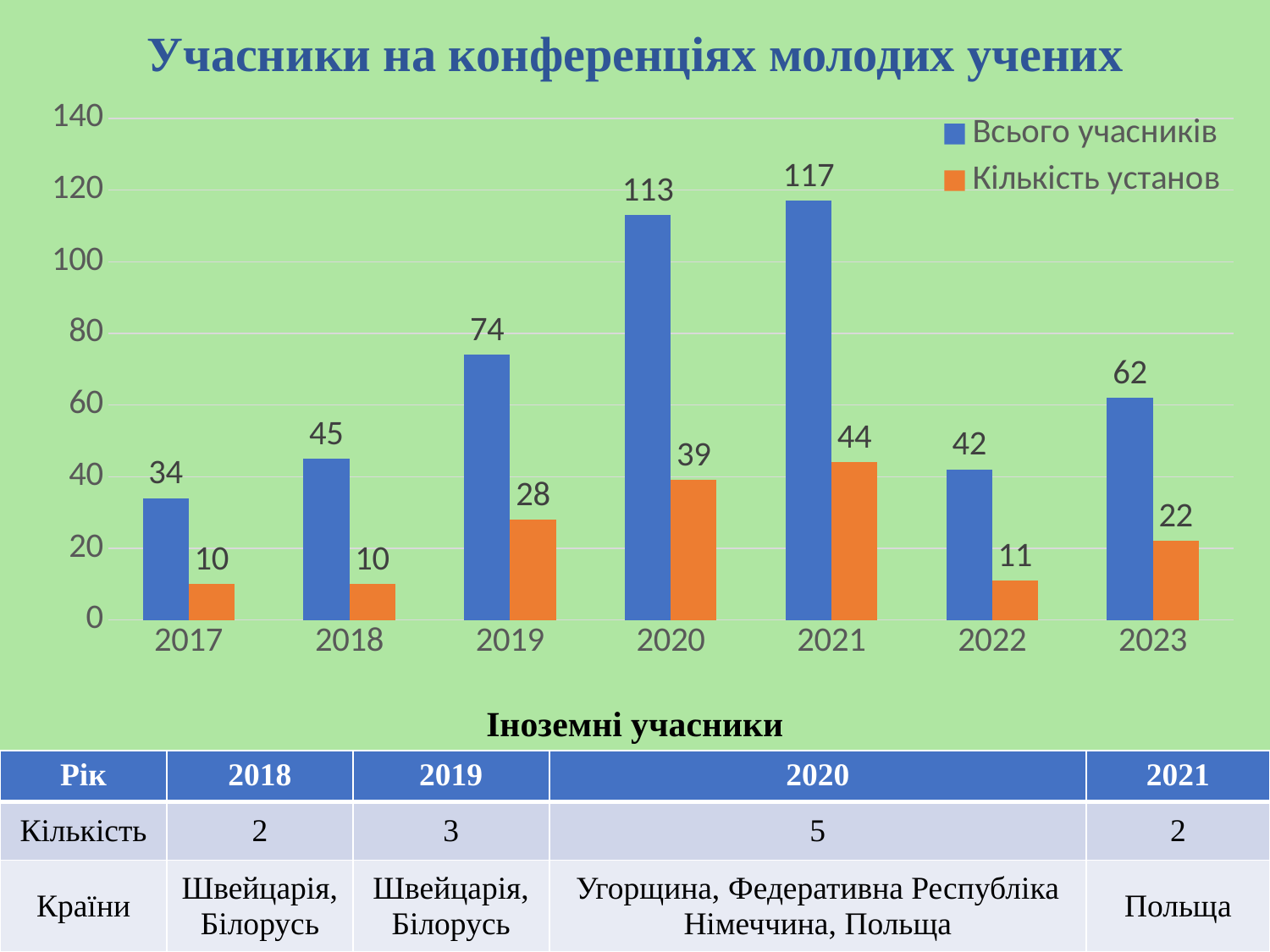
What kind of chart is shown on the slide? bar chart Which year has the highest value for "Всього учасників"? 2021 What is the value of "Кількість установ" for 2019? 28 Which year has the lowest value for "Всього учасників"? 2017 Does "Всього учасників" rise or fall from 2017 to 2021? rise Which is larger: "Кількість установ" in 2020 or in 2023? 2020 How many years are shown on the x axis? 7 Is the value for "Всього учасників" in 2019 greater or less than 60? greater What is the value of "Всього учасників" for 2020? 113 What is the difference between "Всього учасників" in 2021 and 2022? 75 How many series does the legend list? 2 What is the title of the chart? Учасники на конференціях молодих учених